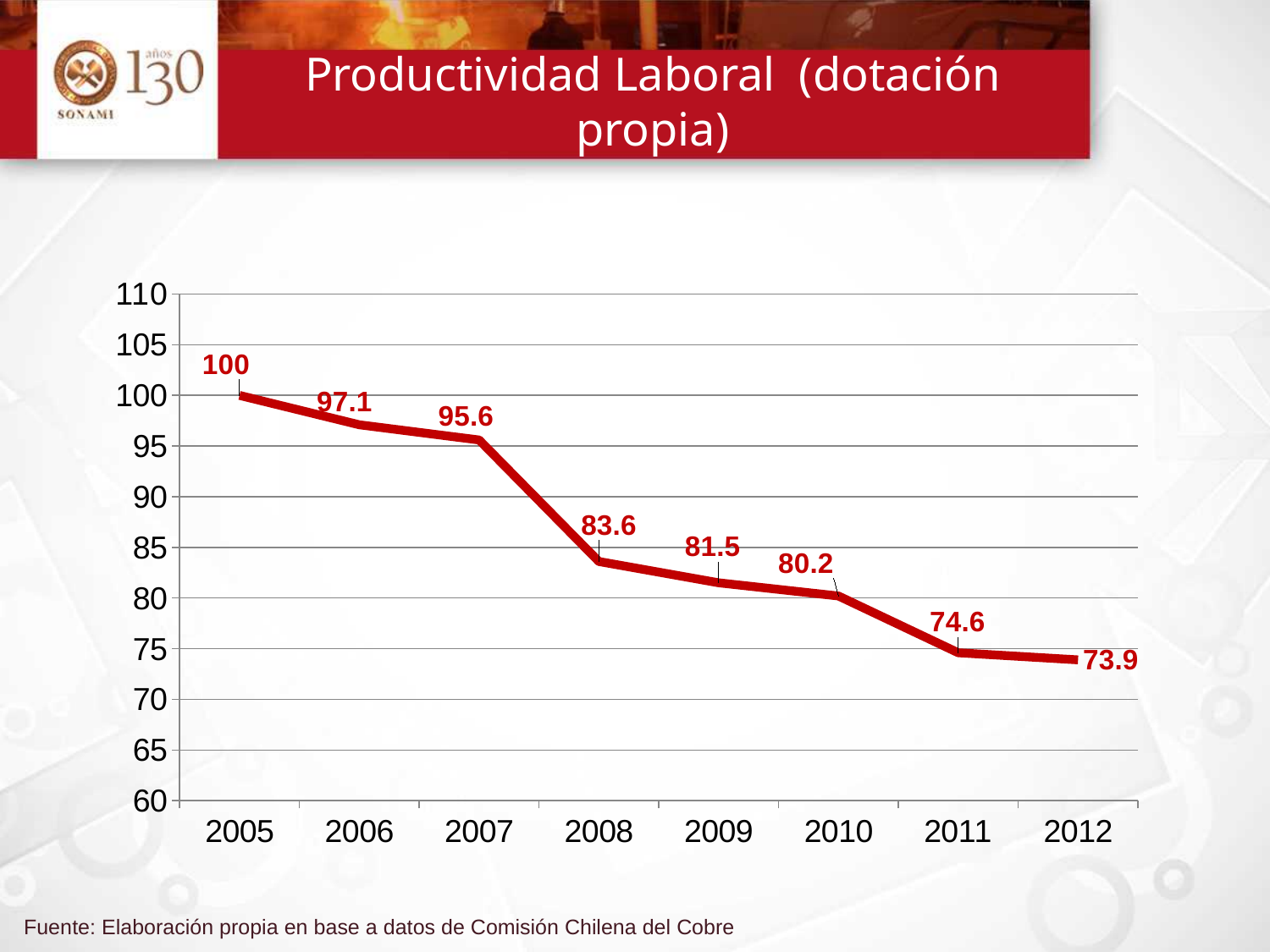
What kind of chart is shown on the slide? line chart What is the value for 2011? 74.6 Which year has the lowest value? 2012 Which year has the highest value? 2005 What is the difference between the values for 2005 and 2012? 26.1 What is the value for 2008? 83.6 Which is larger, the value for 2009 or the value for 2010? 2009 Do the values rise or fall from 2005 to 2012? fall How many years are plotted on the chart? 8 What is the difference between the values for 2007 and 2008? 12 Is the value for 2006 greater or less than 95? greater What is the value for 2005? 100